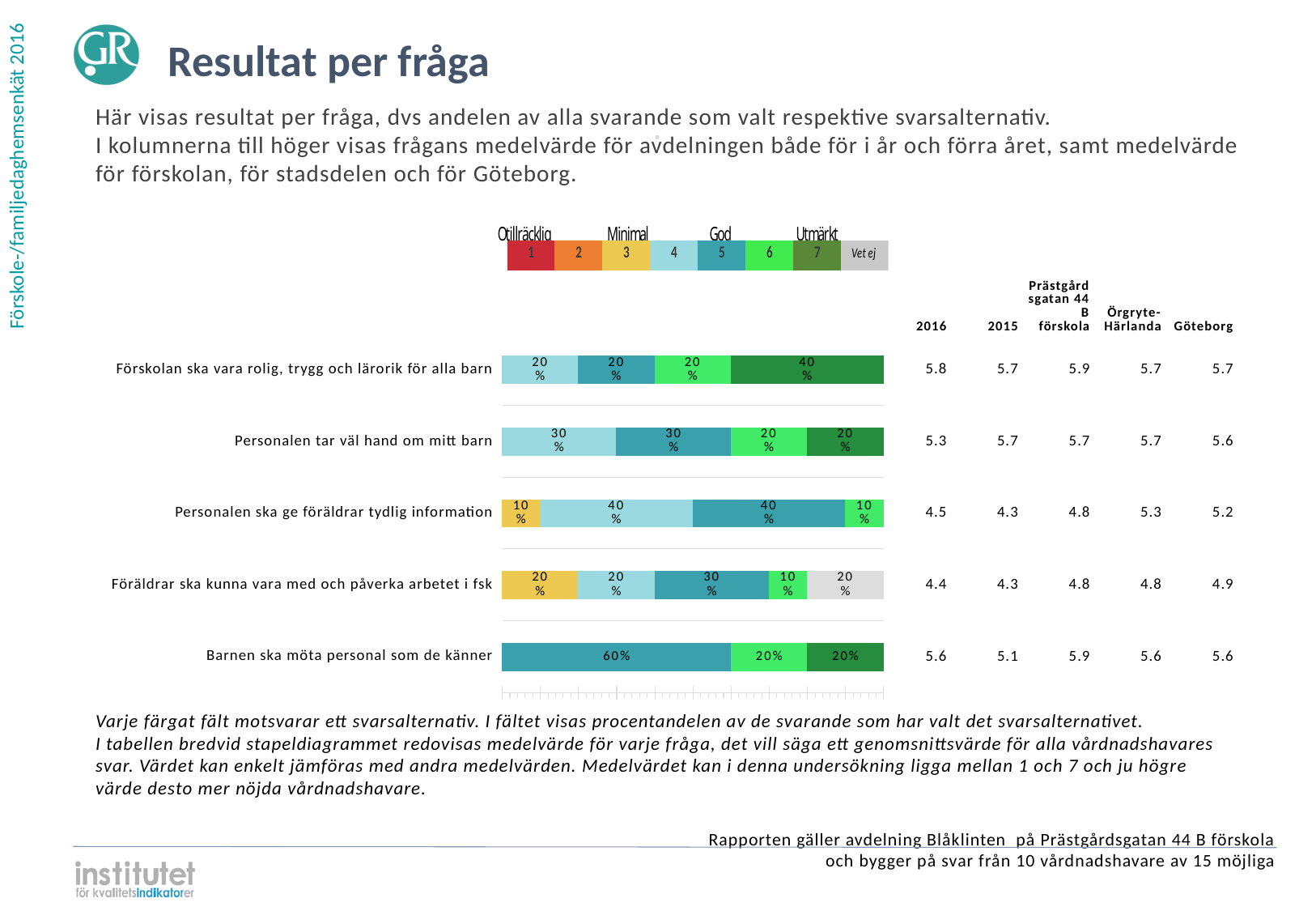
What is the largest segment in the bar for 'Barnen ska möta personal som de känner'? 60% How many questions (categories) are plotted in the bar chart? 5 Which question has the lowest 2016 mean value? Föräldrar ska kunna vara med och påverka arbetet i fsk What is the total of the stacked bar for 'Personalen tar väl hand om mitt barn'? 100% How many answer alternatives does the legend show, including 'Vet ej'? 8 What kind of chart is shown on the slide? Stacked bar chart What share of respondents answered 'Vet ej' for 'Föräldrar ska kunna vara med och påverka arbetet i fsk'? 20% What is the difference between the 40% segment and the 10% segment in the bar for 'Personalen ska ge föräldrar tydlig information'? 30% Which is larger for 'Personalen tar väl hand om mitt barn': the share for answer 4 (light blue) or the share for answer 7 (dark green)? Answer 4 (30%) What is the 2016 mean value for 'Förskolan ska vara rolig, trygg och lärorik för alla barn'? 5.8 Which label in the legend corresponds to answer alternative 7? Utmärkt What share of respondents chose answer 7 (dark green) for 'Förskolan ska vara rolig, trygg och lärorik för alla barn'? 40%